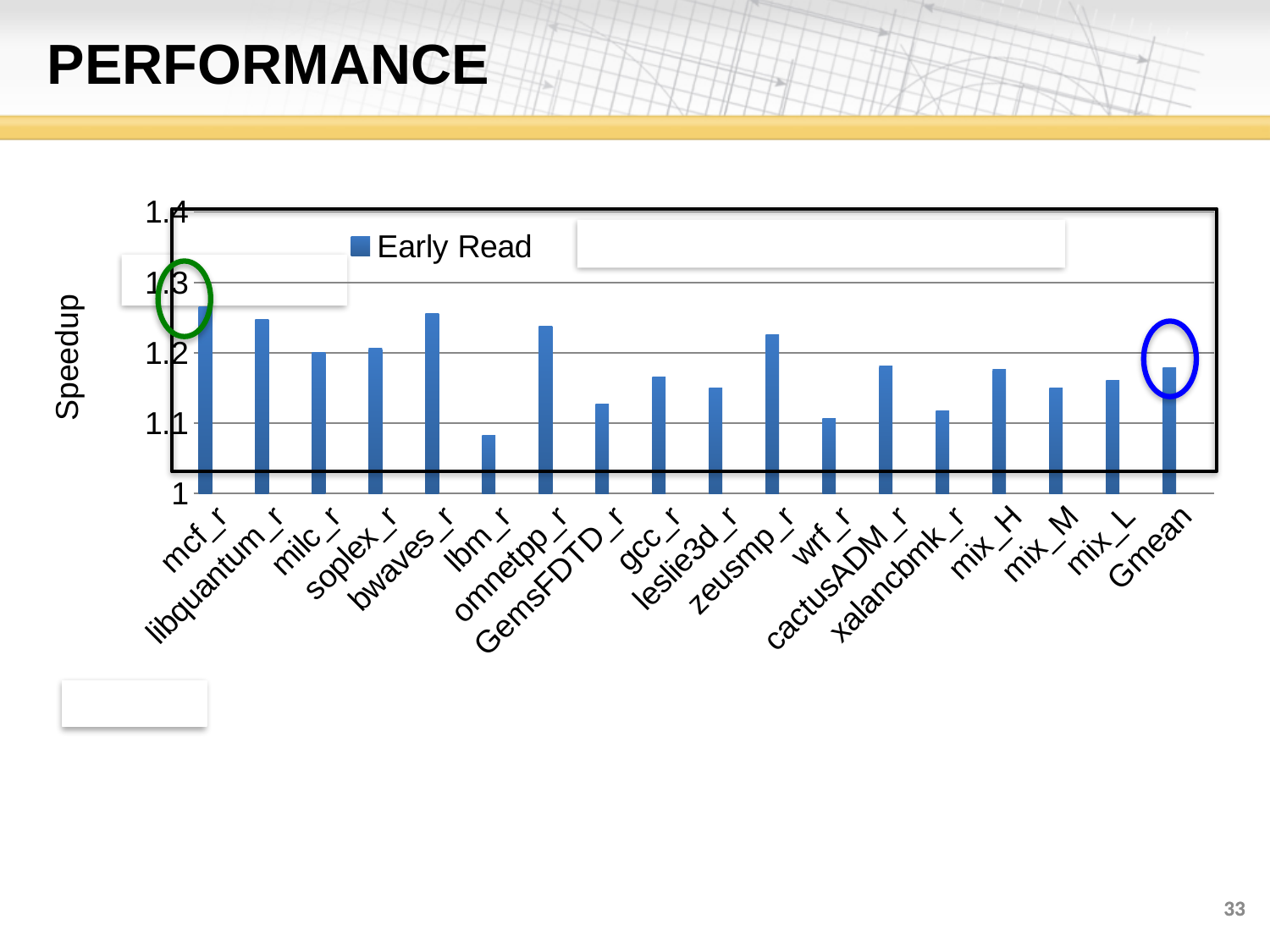
What is the name of the series shown in the chart's legend? Early Read Is the speedup for mcf_r greater or less than 1.2? greater Which has a higher speedup, bwaves_r or GemsFDTD_r? bwaves_r Which has a higher speedup, zeusmp_r or wrf_r? zeusmp_r Is the speedup for Gmean greater or less than 1.2? less How many series does the chart's legend list? 1 Is the speedup for GemsFDTD_r greater or less than 1.1? greater How many categories are shown on the x axis of the chart? 18 What is the label of the chart's y axis? Speedup What kind of chart is shown on the slide? bar chart Which category has the lowest speedup in the chart? lbm_r